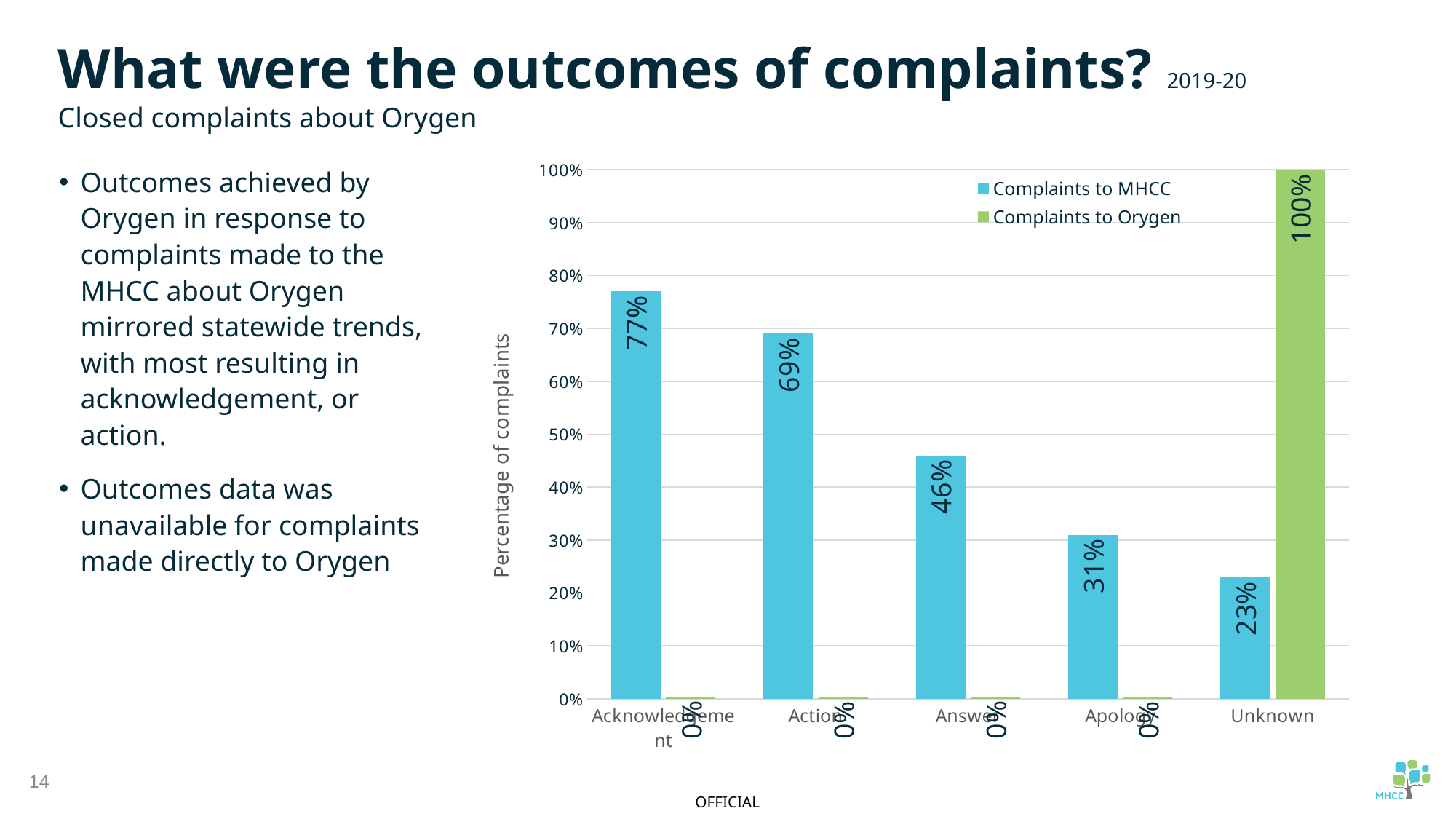
Which outcome category has the highest value for Complaints to MHCC? Acknowledgement What is the value for Complaints to MHCC in the Apology category? 31% For Complaints to MHCC, which is larger: Answer or Apology? Answer What percentage of complaints to MHCC resulted in Acknowledgement? 77% Which outcome category has the lowest value for Complaints to MHCC? Unknown How many series does the legend list? 2 What kind of chart is shown on the slide? Bar chart What is the value for Complaints to Orygen in the Unknown category? 100% What is the label on the vertical axis of the chart? Percentage of complaints What is the difference between the Complaints to MHCC values for Acknowledgement and Action? 8% What percentage of complaints to MHCC resulted in Action? 69% How many outcome categories are shown on the x axis? 5